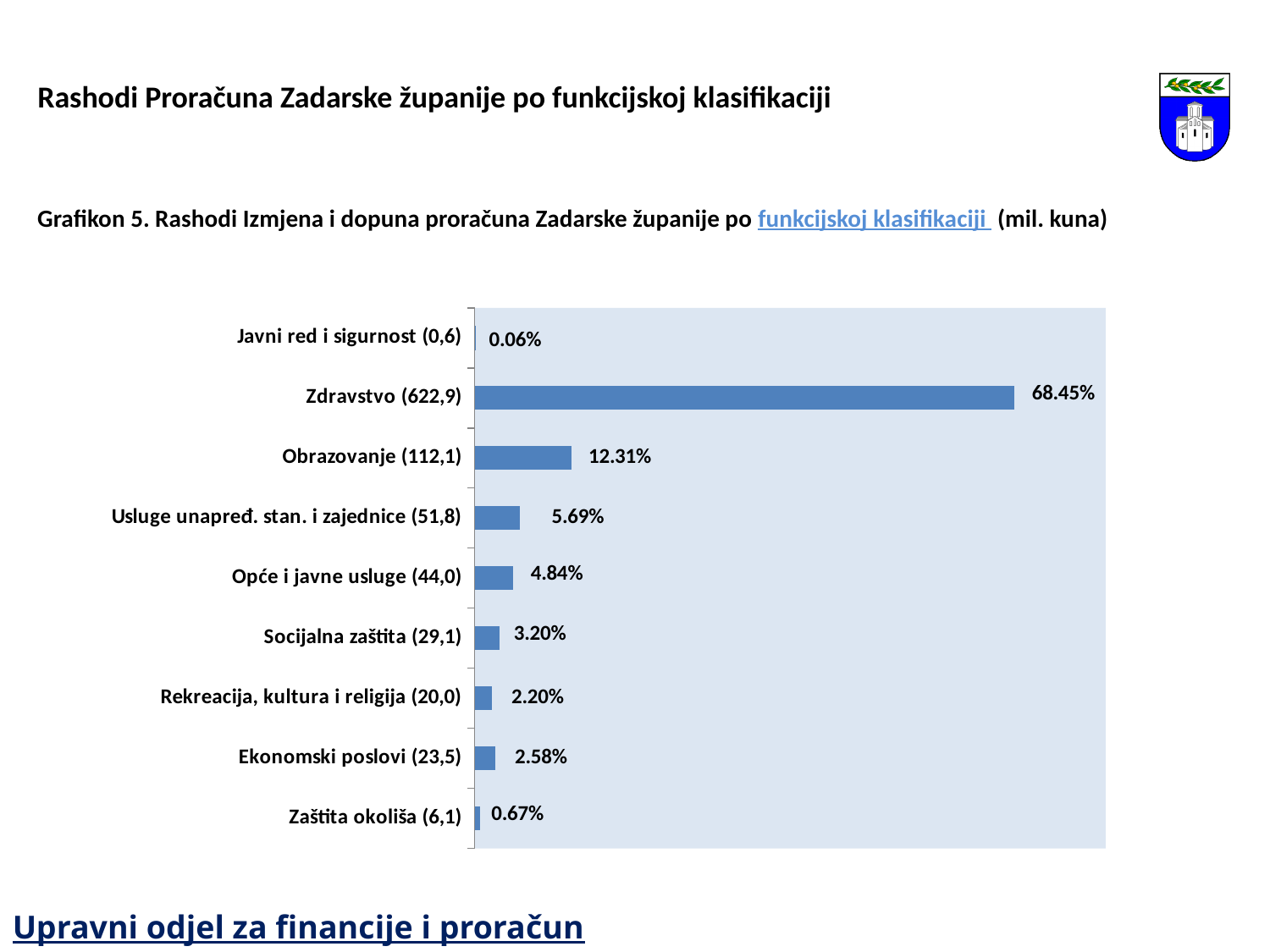
What kind of chart is shown on the slide? Bar chart What unit is stated in the chart caption for the values in parentheses? mil. kuna What is the difference in percentage points between Usluge unapređ. stan. i zajednice (51,8) and Opće i javne usluge (44,0)? 0.85 How many categories are shown in the chart? 9 What percentage is shown for Obrazovanje (112,1)? 12.31% What is the difference in percentage points between Zdravstvo (622,9) and Obrazovanje (112,1)? 56.14 What percentage is shown for Zaštita okoliša (6,1)? 0.67% Which category has the highest percentage? Zdravstvo (622,9) Which is larger, the percentage for Ekonomski poslovi (23,5) or for Rekreacija, kultura i religija (20,0)? Ekonomski poslovi (23,5) Which category has the lowest percentage? Javni red i sigurnost (0,6) What percentage is shown for Zdravstvo (622,9)? 68.45% What percentage is shown for Socijalna zaštita (29,1)? 3.20%